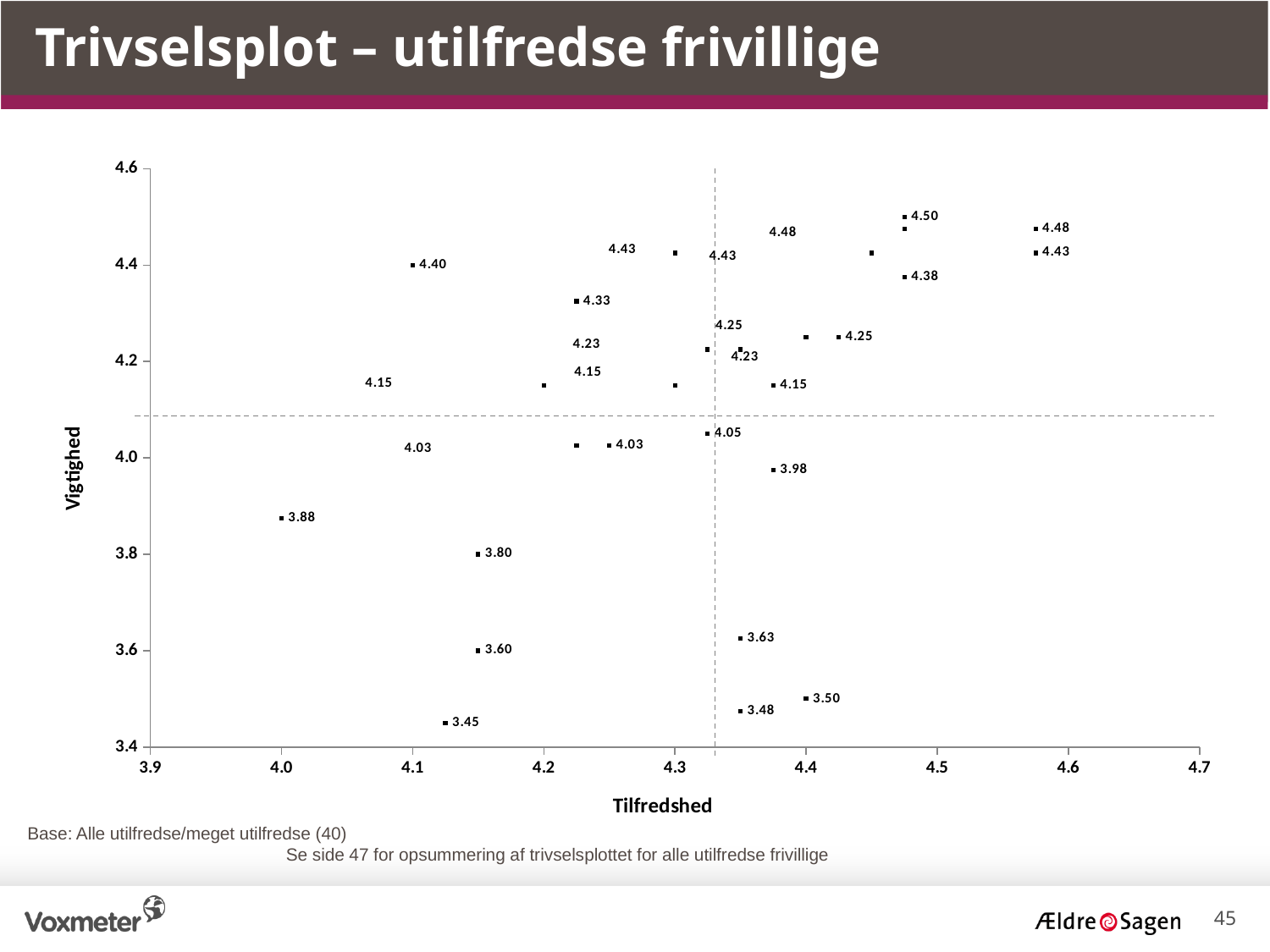
What is the highest Vigtighed value labelled on the chart? 4.50 Which labelled value is larger, 3.63 or 3.60? 3.63 What is the title of the vertical axis? Vigtighed What is the difference between the highest labelled value (4.50) and the lowest labelled value (3.45)? 1.05 What is the title of the horizontal axis? Tilfredshed Is the Tilfredshed value of the point labelled 3.88 greater or less than 4.1? less What is the maximum value shown on the vertical axis? 4.6 What kind of chart is shown on the slide? scatter plot Is the Tilfredshed value of the point labelled 3.45 greater or less than 4.2? less What is the lowest Vigtighed value labelled on the chart? 3.45 Is the Tilfredshed value of the point labelled 4.50 greater or less than 4.4? greater How many points on the chart are labelled 4.43? 3